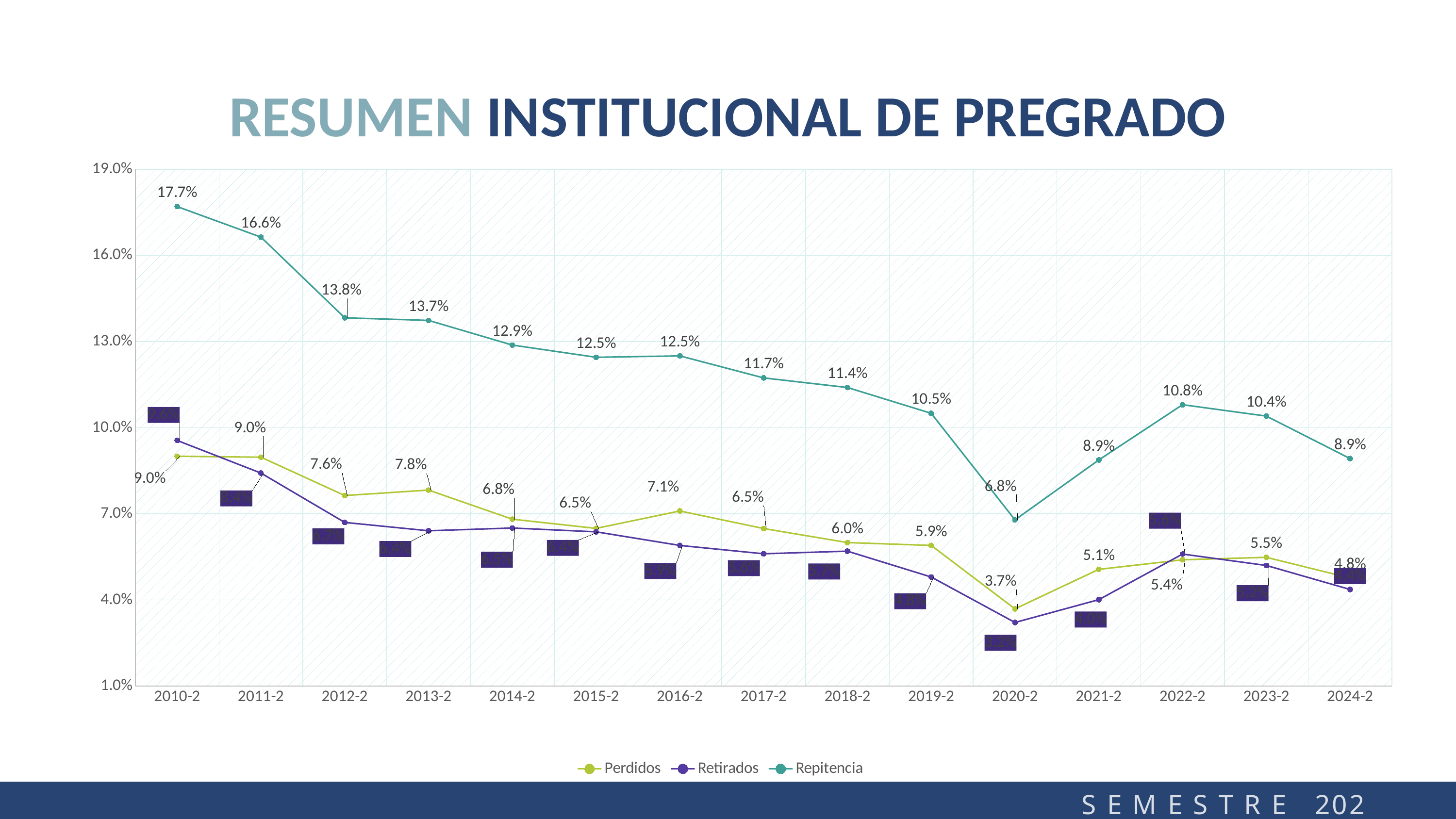
What is the Repitencia value for 2020-2? 6.8% In which semester is the Perdidos series at its lowest? 2020-2 In which semester is the Repitencia series at its highest? 2010-2 How many series does the legend list? 3 What is the difference between the Repitencia values for 2022-2 and 2024-2? 1.9% Which is larger, the Repitencia value for 2019-2 or for 2021-2? 2019-2 What is the Perdidos value for 2024-2? 4.8% What kind of chart is shown on the slide? line chart What is the Perdidos value for 2016-2? 7.1% Is the Retirados value for 2020-2 greater or less than 4.0%? less What is the Repitencia value for 2010-2? 17.7% How many semesters are shown on the x axis? 15